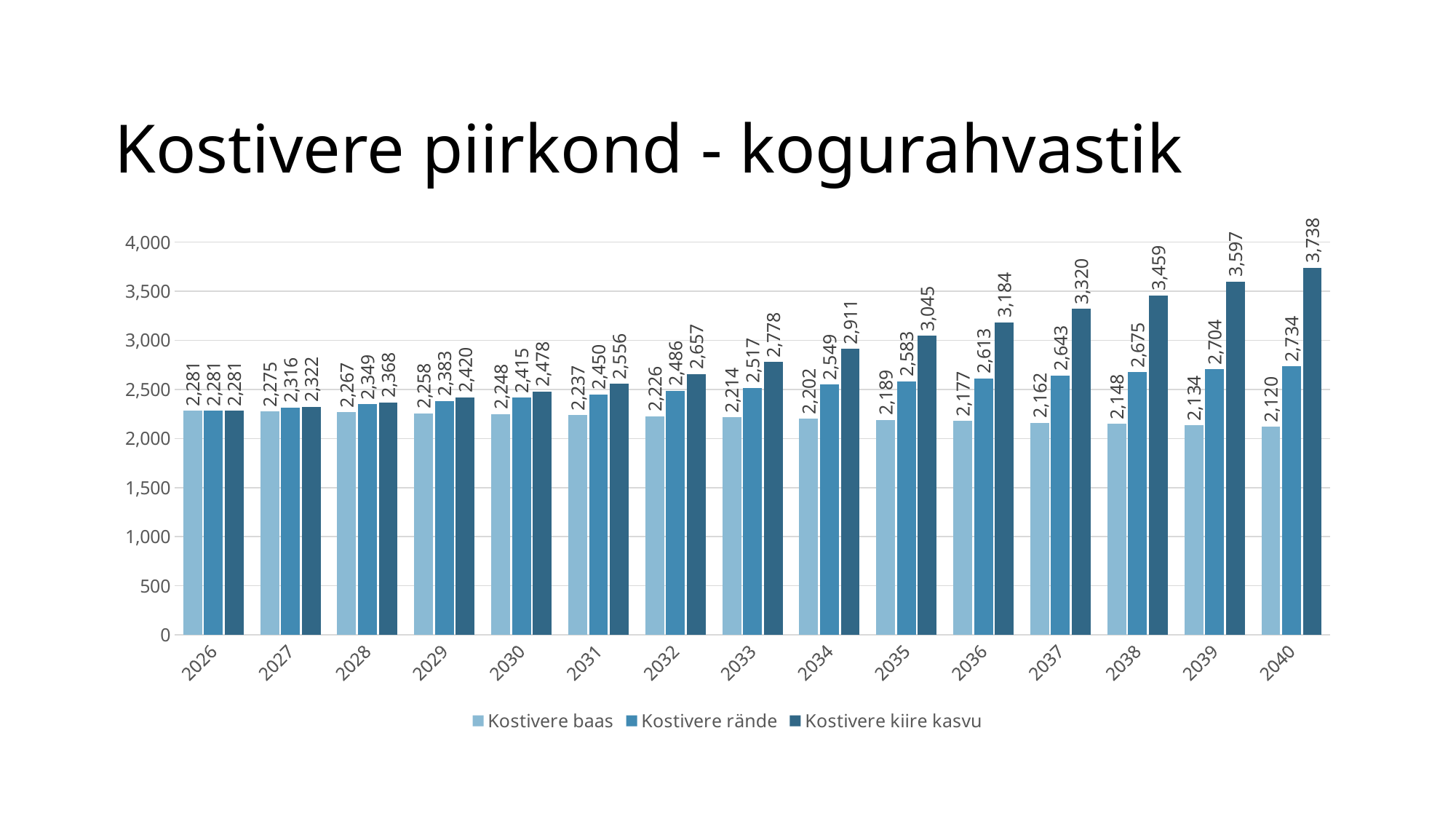
What is the value for Kostivere baas in 2033? 2,214 Do the Kostivere baas values rise or fall from 2026 to 2040? fall What is the title of the chart? Kostivere piirkond - kogurahvastik Which is larger in 2030: Kostivere rände or Kostivere kiire kasvu? Kostivere kiire kasvu What type of chart is shown on the slide? bar chart What is the value for Kostivere kiire kasvu in 2040? 3,738 What is the value for Kostivere rände in 2035? 2,583 How many years are shown on the x axis? 15 In which year is the Kostivere baas value lowest? 2040 In which year is the Kostivere kiire kasvu value highest? 2040 How many series does the legend list? 3 What is the difference between Kostivere kiire kasvu and Kostivere baas in 2040? 1,618